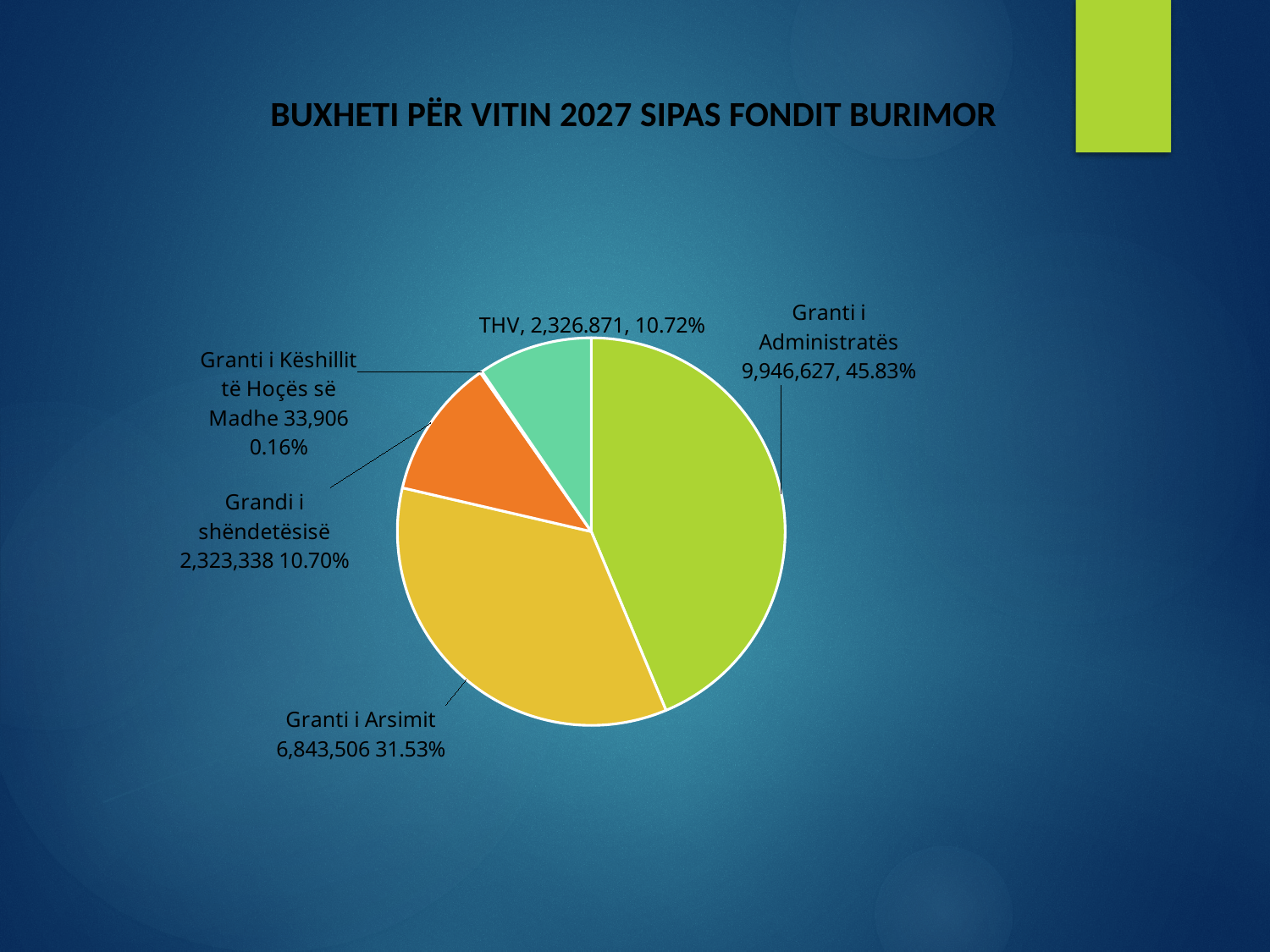
What is the value for Granti i Këshillit të Hoçës së Madhe? 33,906 What is the title of the chart? BUXHETI PËR VITIN 2027 SIPAS FONDIT BURIMOR What is the value for Granti i Arsimit? 6,843,506 What is the value for Grandi i shëndetësisë? 2,323,338 What is the difference between the values for Granti i Administratës and Granti i Arsimit? 3,103,121 What is the value for Granti i Administratës? 9,946,627 Which category has the smallest slice of the pie? Granti i Këshillit të Hoçës së Madhe What share of the pie does THV represent? 10.72% How many slices does the pie chart have? 5 Which category has the largest slice of the pie? Granti i Administratës What share of the pie does Granti i Arsimit represent? 31.53% What type of chart is shown on the slide? Pie chart